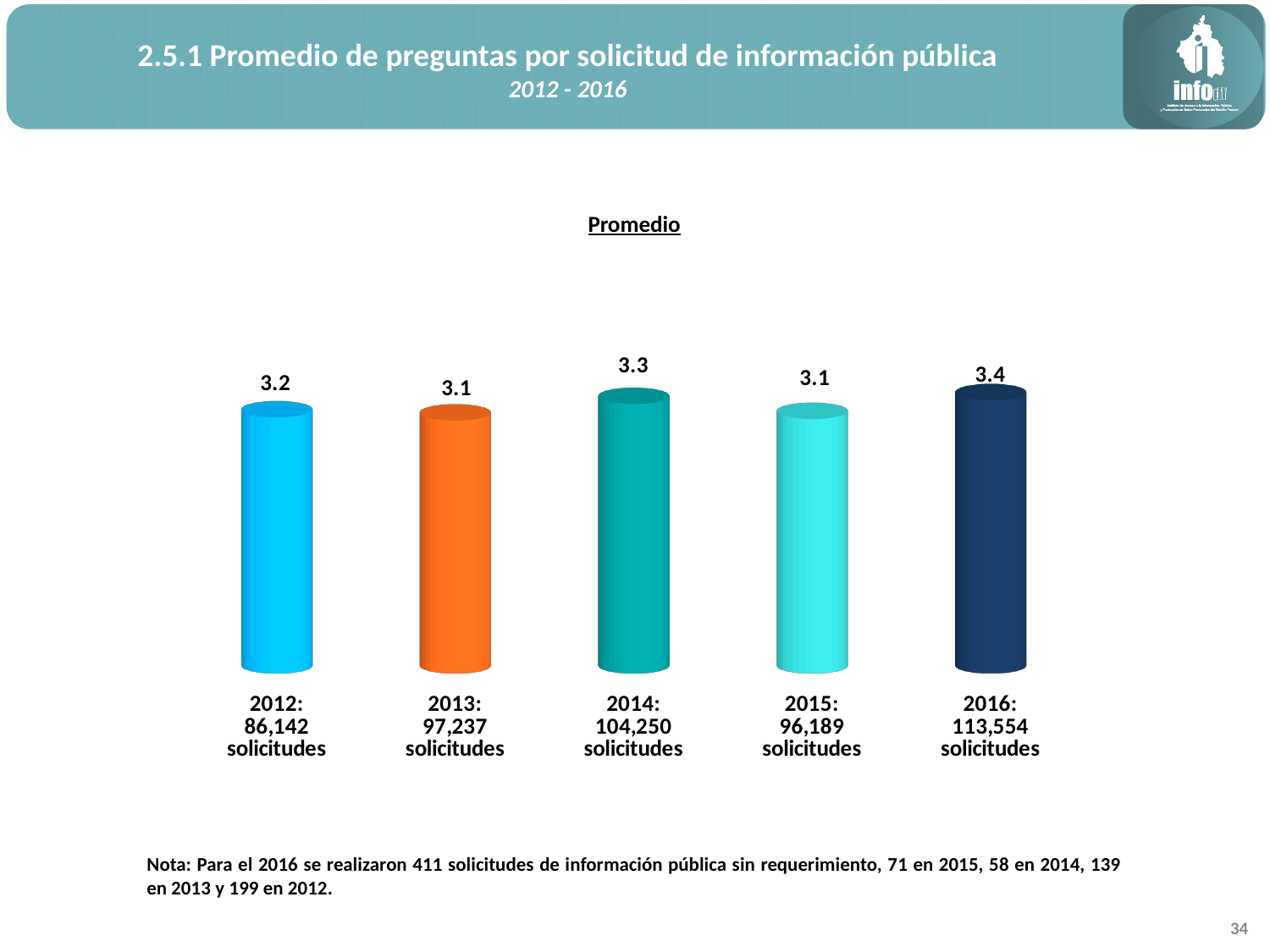
What is the title shown above the chart? Promedio What is the average value shown for 2014? 3.3 How many solicitudes are listed under the 2014 bar label? 104,250 Which is larger, the average for 2014 or the average for 2015? 2014 What is the difference between the average for 2016 and the average for 2013? 0.3 How many years are plotted in the chart? 5 What is the average value shown for 2016? 3.4 Which year has the highest average? 2016 What colour is the bar for 2013? Orange What is the average number of questions per request shown for 2012? 3.2 Which years share the lowest average value? 2013 and 2015 What kind of chart is shown on the slide? Bar chart